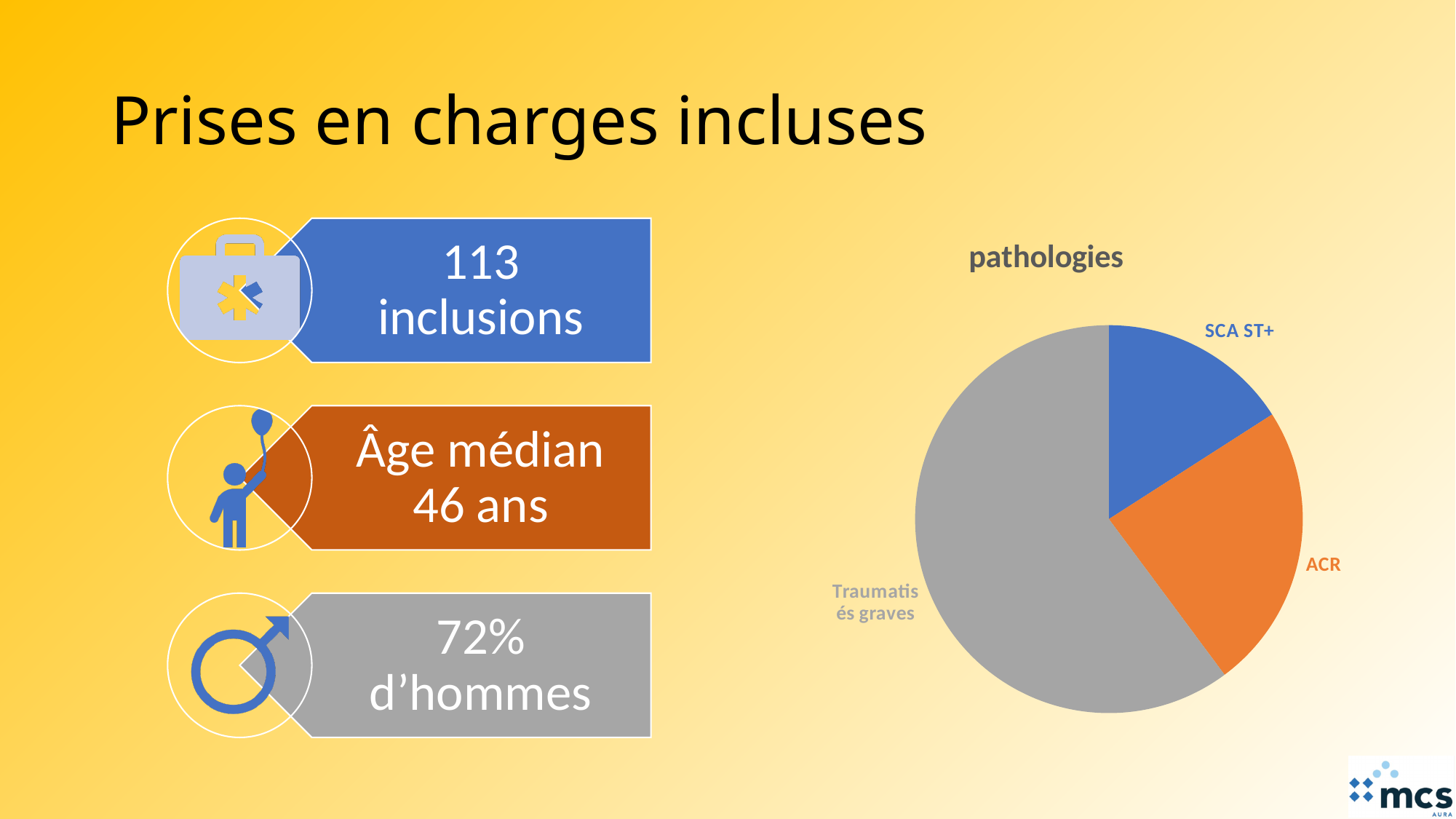
What kind of chart is shown on the slide? pie chart Does the Traumatisés graves slice make up more or less than half of the pie? more Which slice is larger, ACR or SCA ST+? ACR Which slice is larger, Traumatisés graves or ACR? Traumatisés graves Which category has the largest slice of the pie chart? Traumatisés graves Which category has the smallest slice of the pie chart? SCA ST+ What is the title of the chart? pathologies What colour is the ACR slice of the pie chart? orange How many slices does the pie chart have? 3